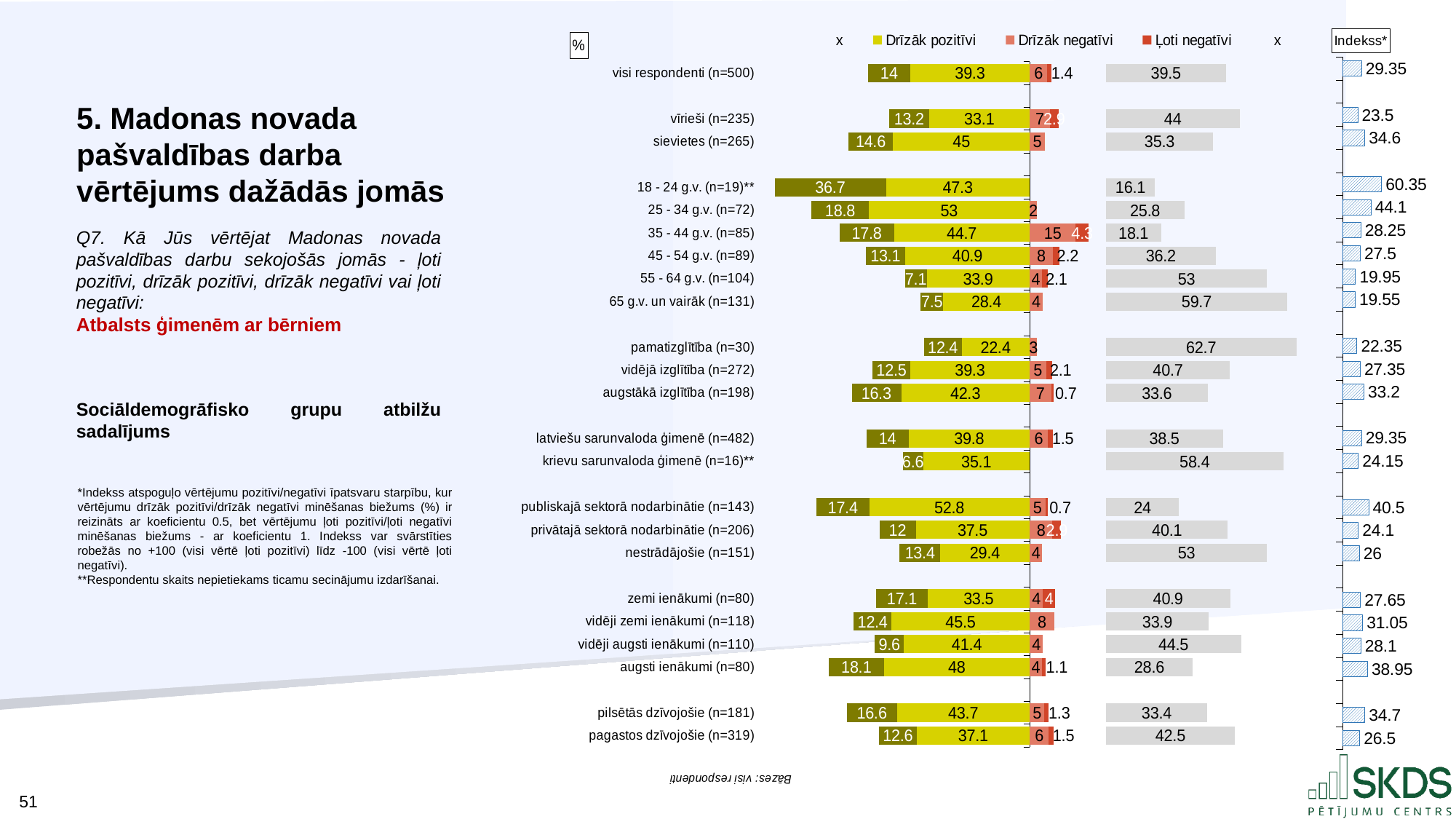
How many respondent groups (rows) are plotted in the chart? 23 Which group has the lowest Indekss* value? 65 g.v. un vairāk (n=131) What is the Indekss* value for '18 - 24 g.v. (n=19)**'? 60.35 What kind of chart is shown on the slide? bar chart What is the 'Drīzāk pozitīvi' value for 'publiskajā sektorā nodarbinātie (n=143)'? 52.8 What is the difference between the Indekss* values for 'sievietes (n=265)' and 'vīrieši (n=235)'? 11.1 What is the grey bar value for 'pamatizglītība (n=30)'? 62.7 What is the 'Drīzāk pozitīvi' value for 'visi respondenti (n=500)'? 39.3 Which has a larger 'Drīzāk pozitīvi' value: '25 - 34 g.v. (n=72)' or '35 - 44 g.v. (n=85)'? 25 - 34 g.v. (n=72) What is the Indekss* value for 'augsti ienākumi (n=80)'? 38.95 Which area of municipal work is evaluated in this chart, as shown in red text on the slide? Atbalsts ģimenēm ar bērniem Which group has the highest Indekss* value? 18 - 24 g.v. (n=19)**